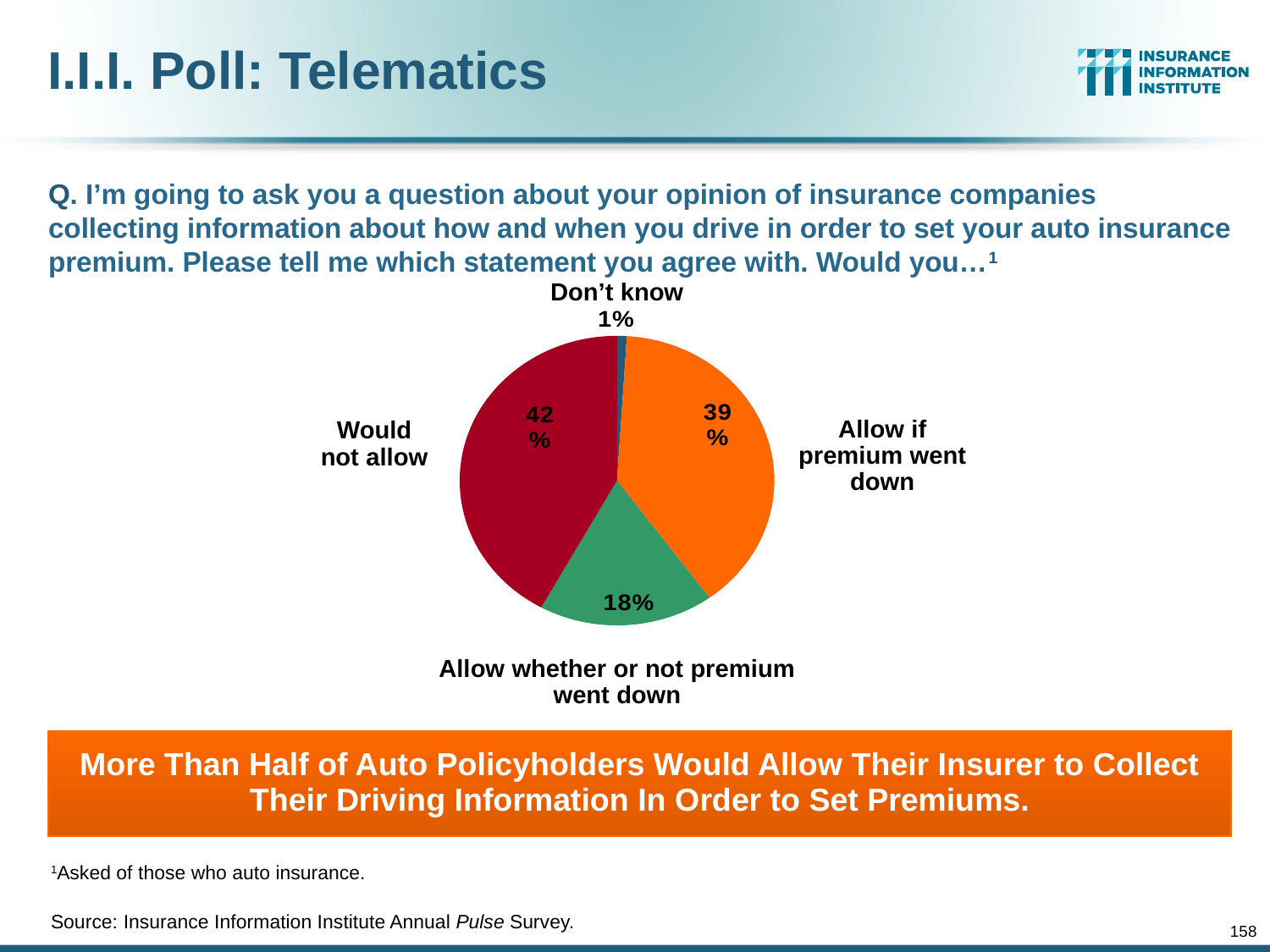
What colour is the 'Allow if premium went down' slice? Orange Which response has the largest share of the pie? Would not allow What kind of chart is shown on the slide? Pie chart Which is larger: the share for 'Allow whether or not premium went down' or the share for 'Would not allow'? Would not allow What is the difference in percentage points between 'Would not allow' and 'Allow if premium went down'? 3 How many response categories are shown in the pie chart? 4 What percentage of respondents would not allow insurers to collect driving information? 42% What percentage of respondents would allow it if their premium went down? 39% What percentage of respondents would allow it whether or not their premium went down? 18% Which response has the smallest share of the pie? Don't know What percentage of respondents answered 'Don't know'? 1% What is the difference in percentage points between 'Allow if premium went down' and 'Allow whether or not premium went down'? 21